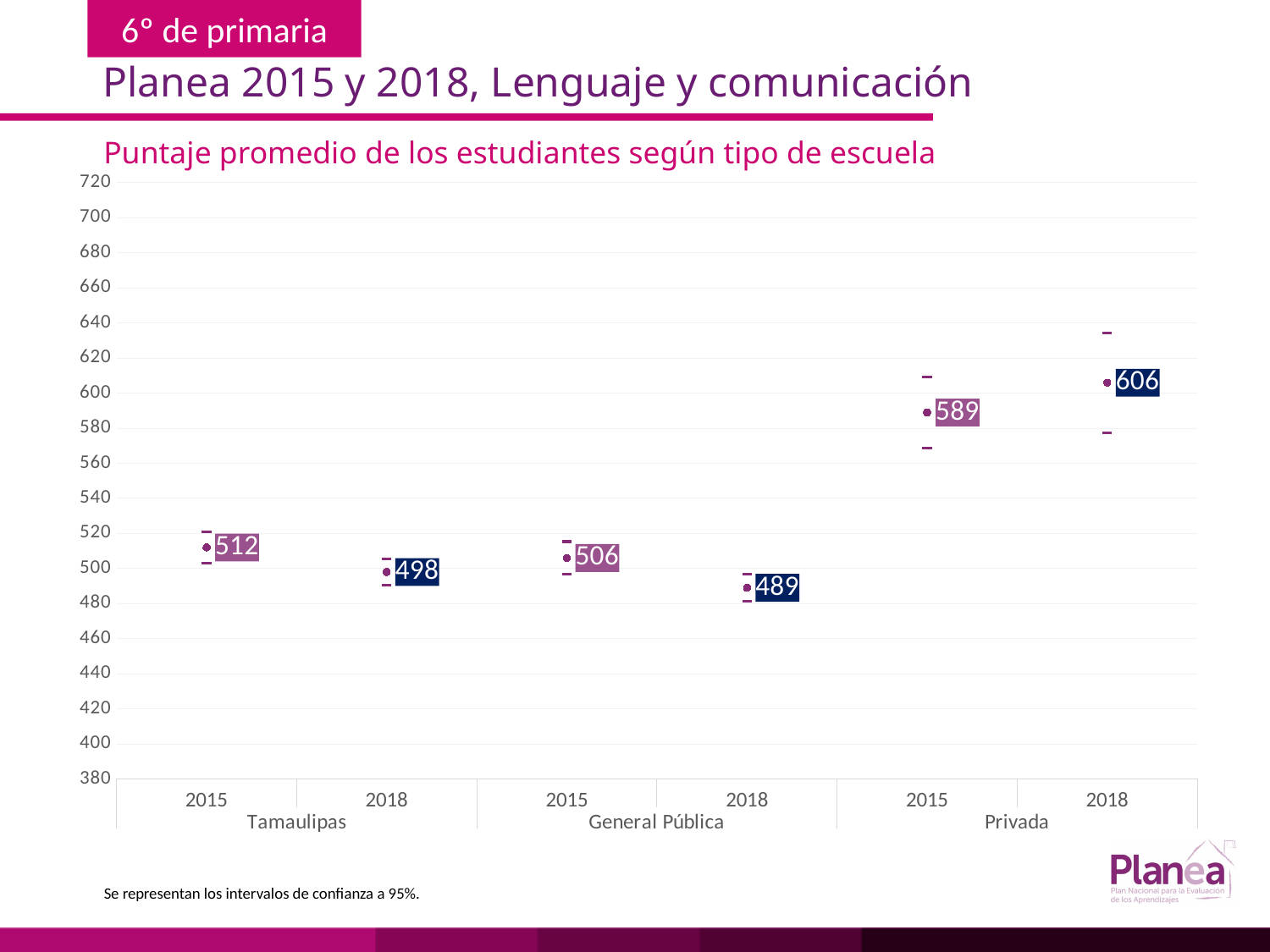
Which is larger, the 2015 score for Tamaulipas or the 2015 score for General Pública? Tamaulipas What is the average score for Privada schools in 2018? 606 What is the average score for General Pública schools in 2018? 489 By how much did the Tamaulipas score change from 2015 to 2018? 14 What is the difference between the Privada scores in 2018 and 2015? 17 What is the average score for Tamaulipas in 2018? 498 What is the average score for Tamaulipas in 2015? 512 Which group and year has the highest average score? Privada 2018 What is the title of the chart? Puntaje promedio de los estudiantes según tipo de escuela Which group and year has the lowest average score? General Pública 2018 How many data points are plotted on the chart? 6 Is the 2015 score for Privada schools greater or less than 600? less